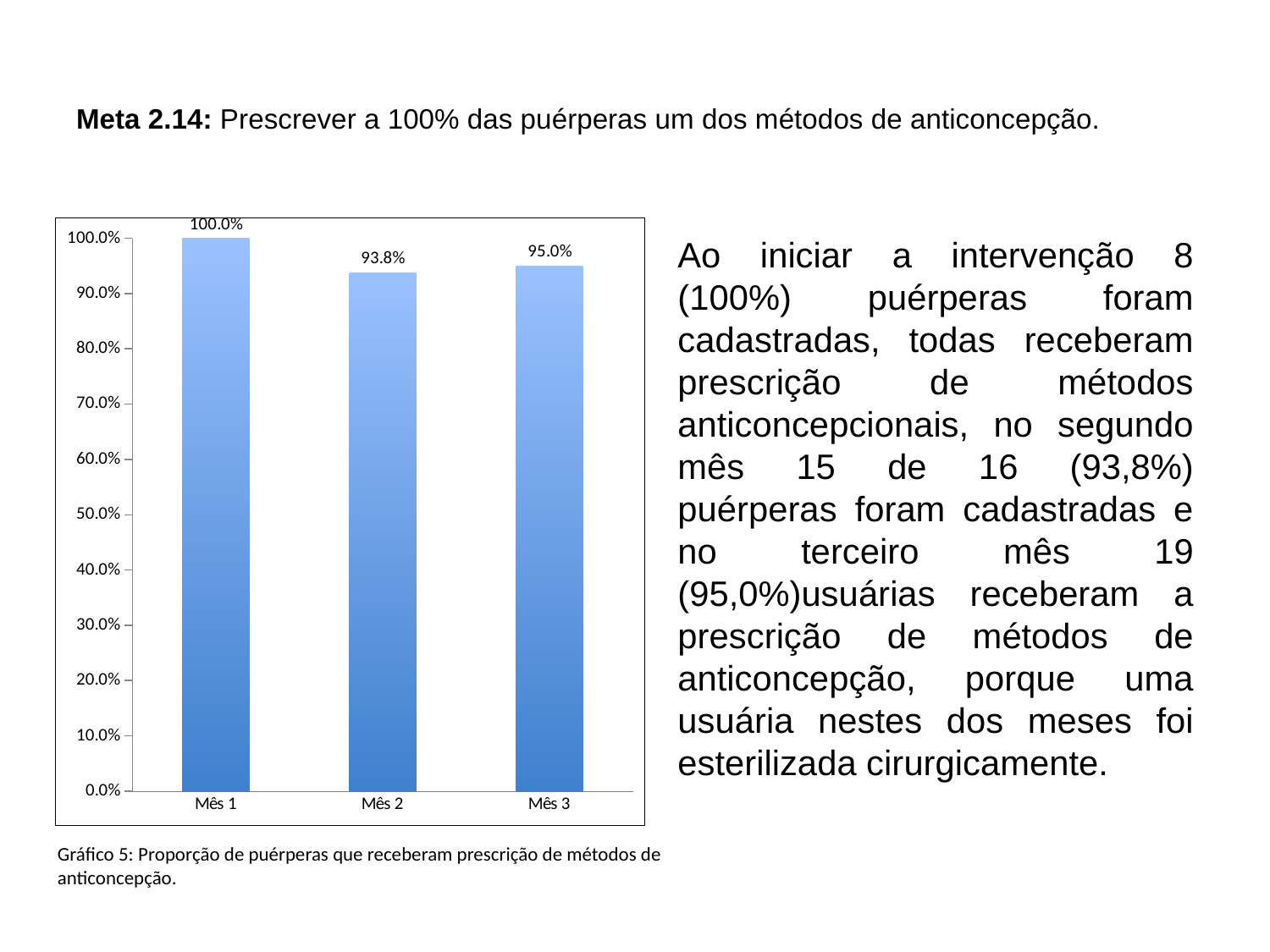
Which month has the lowest value? Mês 2 What is the value for Mês 1? 100.0% Which month has the highest value? Mês 1 What is the difference between the values for Mês 1 and Mês 2? 6.2% Which is larger, the value for Mês 2 or Mês 3? Mês 3 What is the difference between the values for Mês 3 and Mês 2? 1.2% What is the caption of the chart (Gráfico 5)? Proporção de puérperas que receberam prescrição de métodos de anticoncepção. Is the value for Mês 2 greater or less than 90.0%? greater How many months are shown on the x axis? 3 What kind of chart is shown? bar chart What is the value for Mês 2? 93.8% What is the value for Mês 3? 95.0%